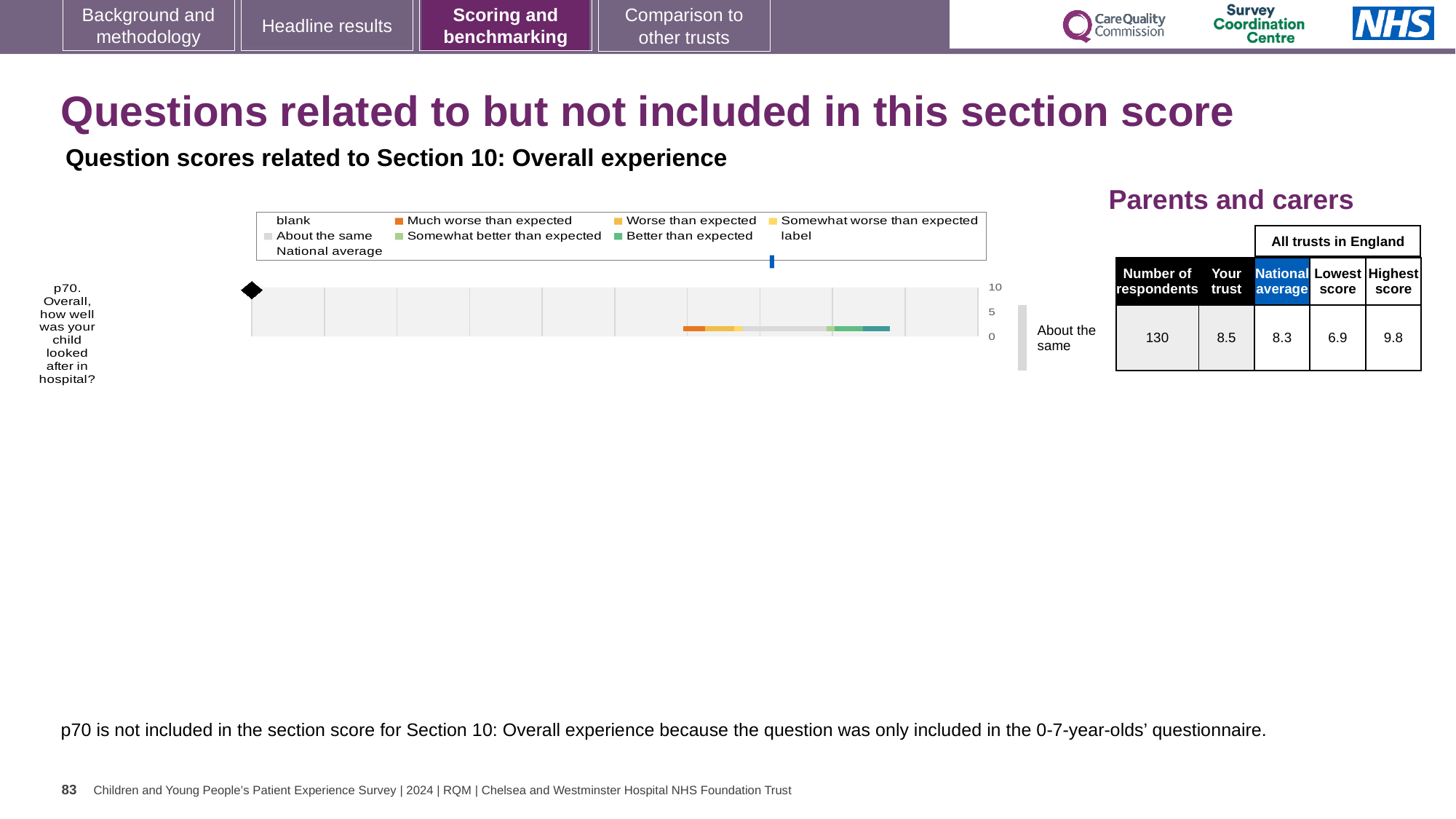
What is the 'Your trust' score for p70 in the Parents and carers table? 8.5 What is the difference between the highest score and the lowest score for p70? 2.9 Which is higher for p70, the 'Your trust' score or the national average? Your trust What is the lowest score among all trusts in England for p70? 6.9 What kind of chart is shown for question p70? bar chart By how much does the 'Your trust' score for p70 exceed the national average? 0.2 How many respondents answered p70? 130 What is the national average score for p70? 8.3 What benchmark category label is shown next to the chart for p70? About the same What is the highest score among all trusts in England for p70? 9.8 How many survey questions are plotted in the chart? 1